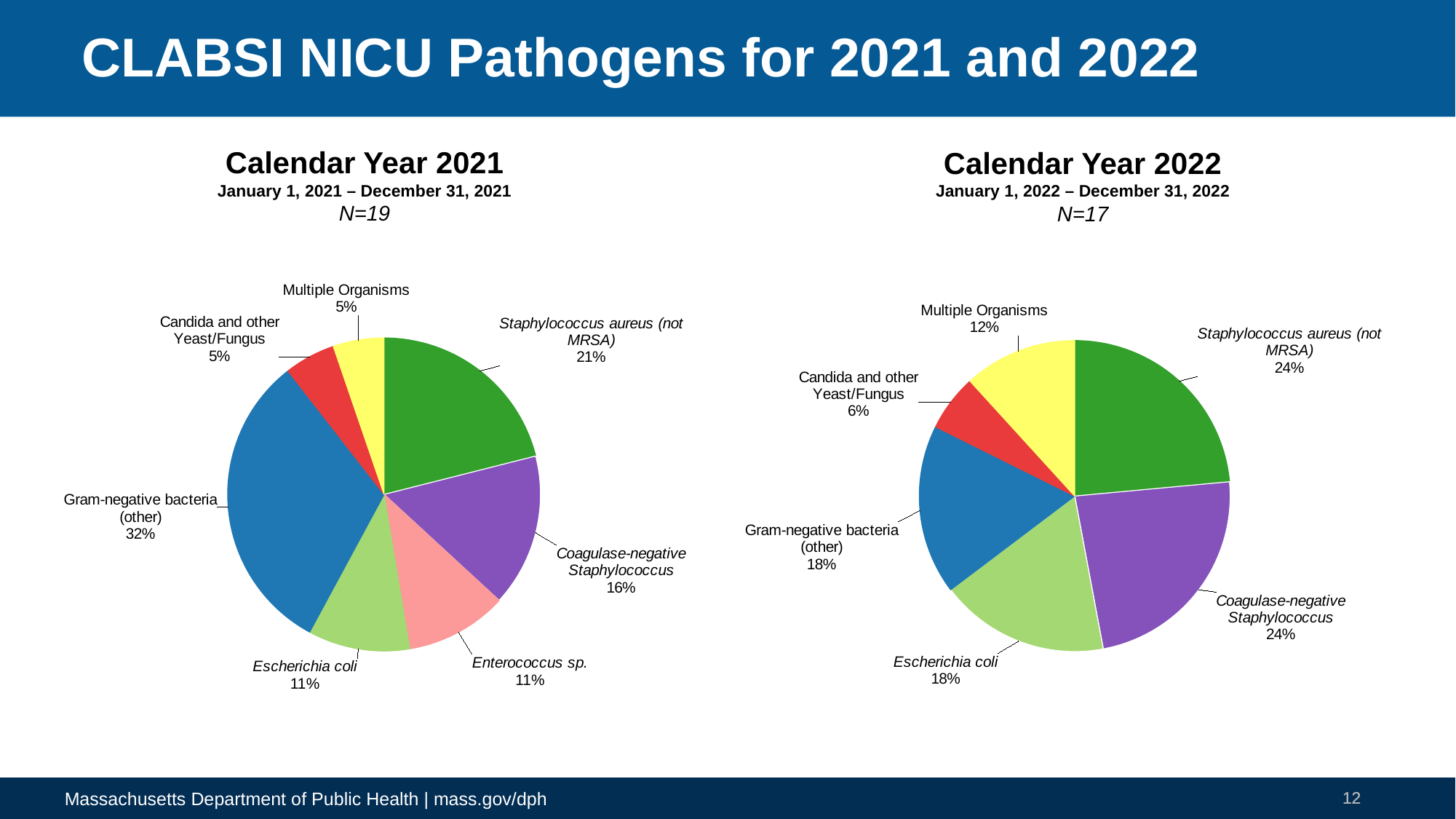
In the Calendar Year 2021 chart, what share of pathogens is Gram-negative bacteria (other)? 32% How many pathogen categories are shown in the Calendar Year 2022 chart? 6 In the Calendar Year 2021 chart, what is the difference in percentage points between Gram-negative bacteria (other) and Staphylococcus aureus (not MRSA)? 11 percentage points In the Calendar Year 2021 chart, what colour is the Gram-negative bacteria (other) slice? Blue In the Calendar Year 2022 chart, which pathogen category has the smallest share? Candida and other Yeast/Fungus What is the total number of cases (N) for the Calendar Year 2022 chart? N=17 In the Calendar Year 2021 chart, what share of pathogens is Enterococcus sp.? 11% In the Calendar Year 2022 chart, which is larger: the share for Escherichia coli or the share for Candida and other Yeast/Fungus? Escherichia coli How many pathogen categories are shown in the Calendar Year 2021 chart? 7 In the Calendar Year 2021 chart, which pathogen category has the largest share? Gram-negative bacteria (other) In the Calendar Year 2022 chart, what share of pathogens is Multiple Organisms? 12% What type of chart is used for Calendar Year 2022? Pie chart